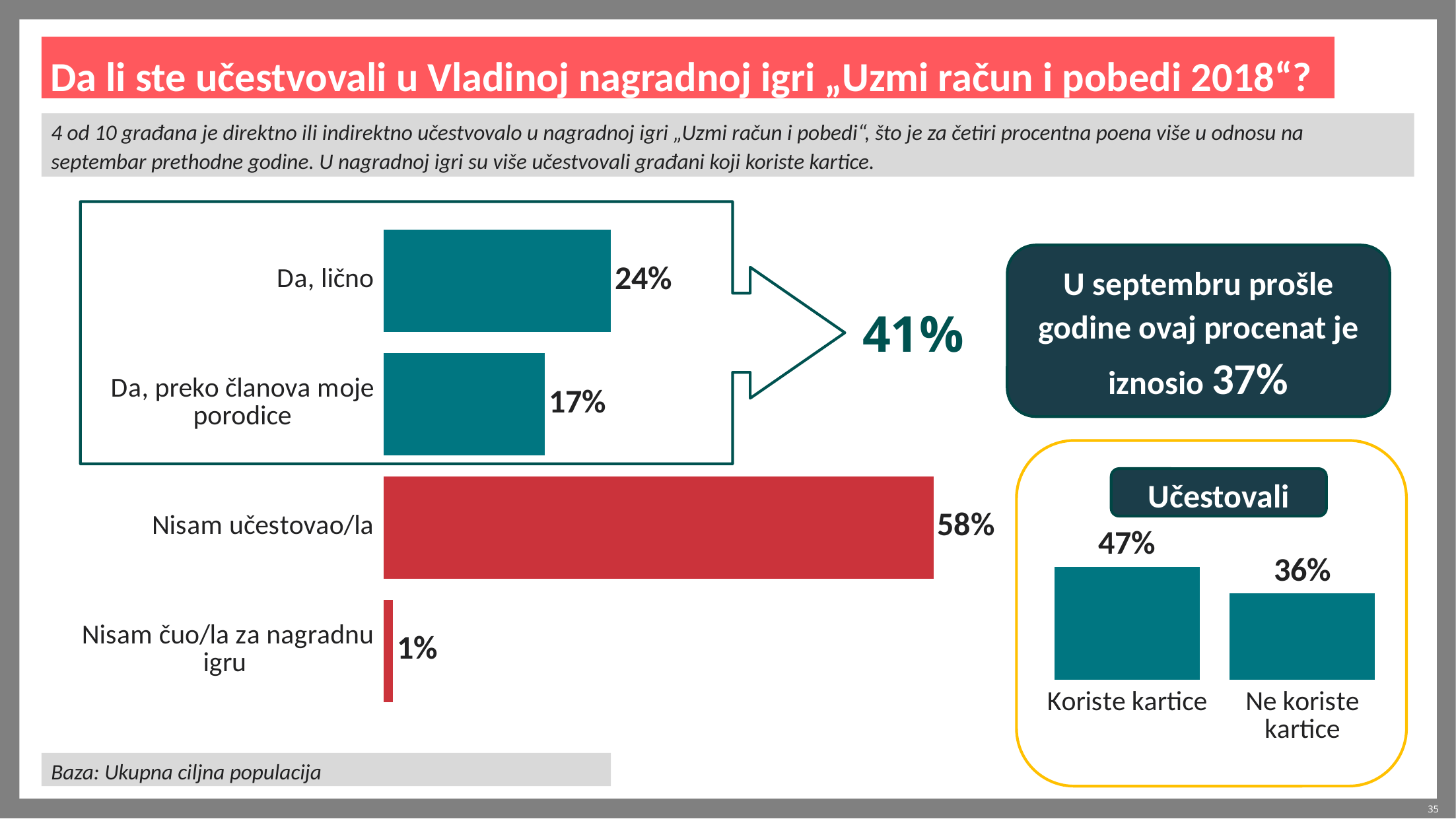
In the horizontal bar chart on the left, how many categories are shown? 4 In the "Učestovali" chart on the right, what is the difference between "Koriste kartice" and "Ne koriste kartice"? 11% In the "Učestovali" chart on the right, what is the value for "Ne koriste kartice"? 36% In the "Učestovali" chart on the right, which is larger, "Koriste kartice" or "Ne koriste kartice"? Koriste kartice In the horizontal bar chart on the left, what is the value for "Da, preko članova moje porodice"? 17% In the horizontal bar chart on the left, which category has the highest value? Nisam učestovao/la In the horizontal bar chart on the left, what is the value for "Nisam učestovao/la"? 58% In the horizontal bar chart on the left, which category has the lowest value? Nisam čuo/la za nagradnu igru What kind of chart is the chart on the left of the slide? Bar chart In the horizontal bar chart on the left, what is the value for "Da, lično"? 24% In the "Učestovali" chart on the right, what is the value for "Koriste kartice"? 47% In the horizontal bar chart on the left, what is the difference between "Da, lično" and "Da, preko članova moje porodice"? 7%